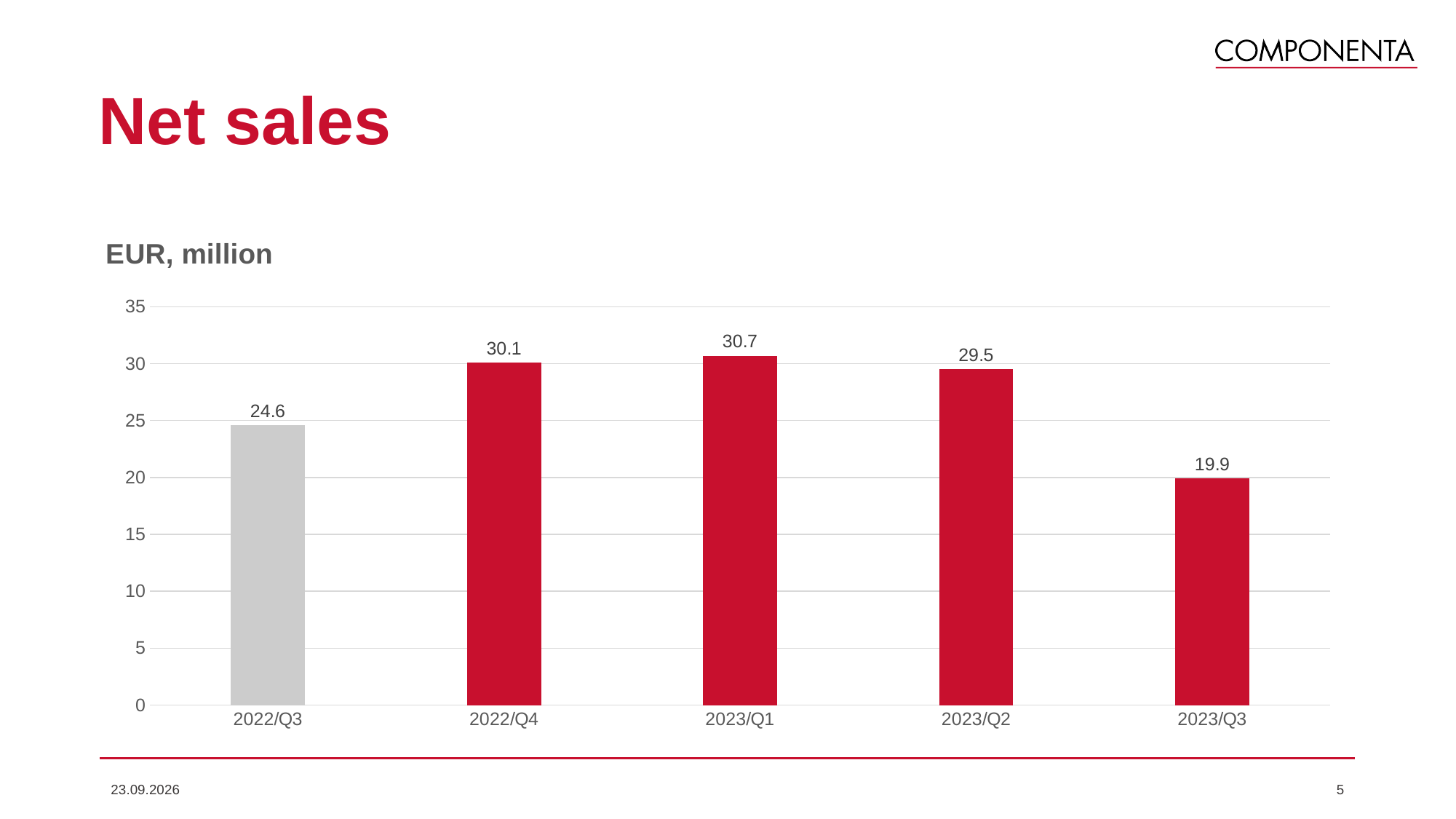
What type of chart is shown on the slide? Bar chart Which quarter has the lowest net sales? 2023/Q3 What is the net sales value for 2023/Q1? 30.7 What is the net sales value for 2022/Q3? 24.6 Which quarter has the highest net sales? 2023/Q1 Is the net sales value for 2023/Q3 greater or less than 20? less In what unit are the net sales values shown? EUR, million What is the difference in net sales between 2023/Q2 and 2023/Q3? 9.6 What is the difference in net sales between 2022/Q4 and 2022/Q3? 5.5 How many quarters are shown on the chart? 5 What is the net sales value for 2023/Q3? 19.9 Which quarter has higher net sales, 2022/Q4 or 2023/Q2? 2022/Q4